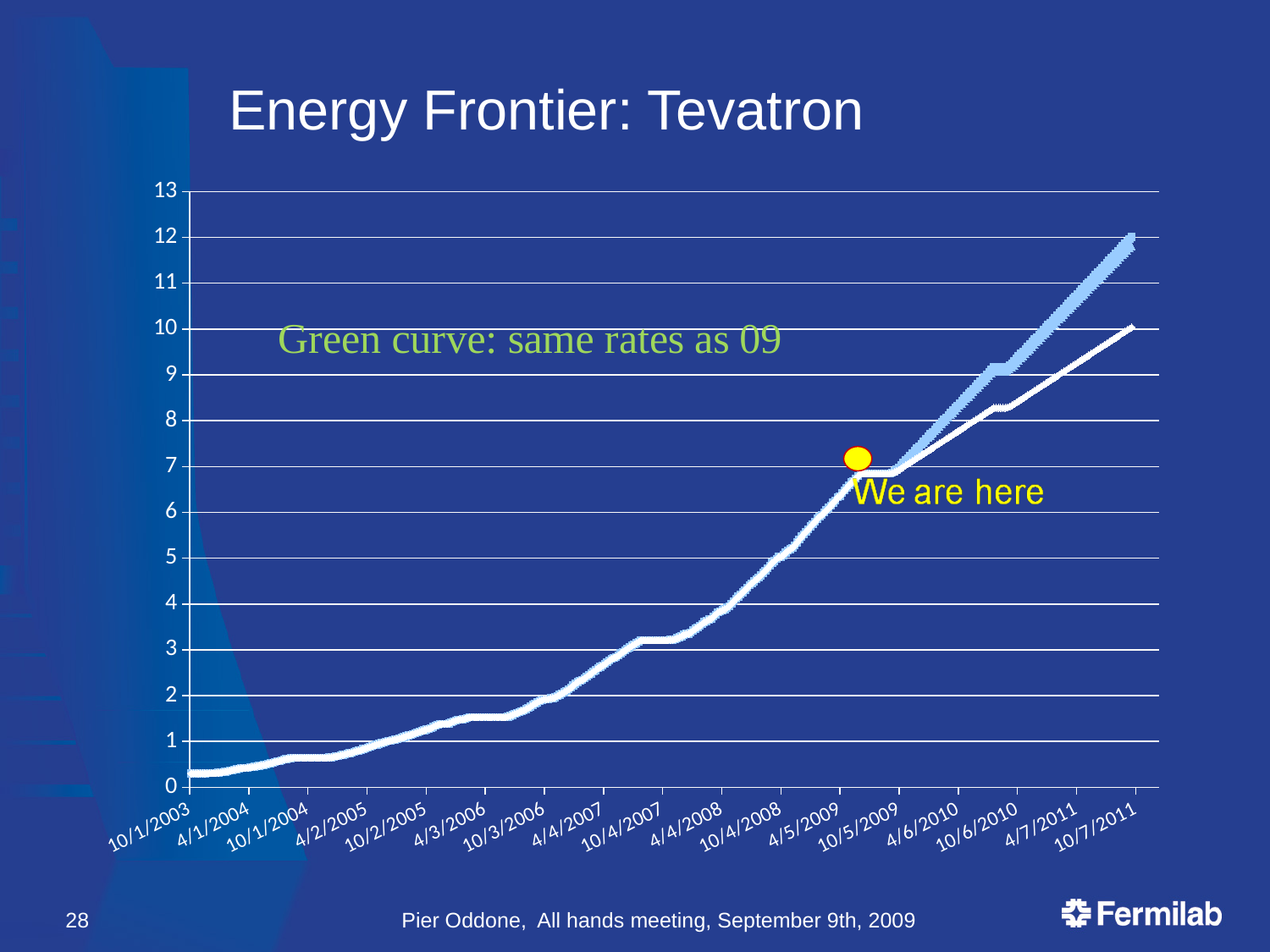
Do the plotted curves rise or fall as the dates on the x axis advance? rise Is the value of the curve at 4/3/2006 greater or less than 2? less At 10/7/2011, which curve is higher, the light blue curve or the white curve? the light blue curve What does the yellow-labelled annotation next to the yellow marker on the chart say? We are here What kind of chart is shown on the slide? line chart Is the value of the upper (light blue) curve at 10/7/2011 greater or less than 11? greater Is the value of the curve at 4/4/2008 greater or less than 4? less What is the title of the chart on the slide? Energy Frontier: Tevatron How many date labels are shown along the x axis? 17